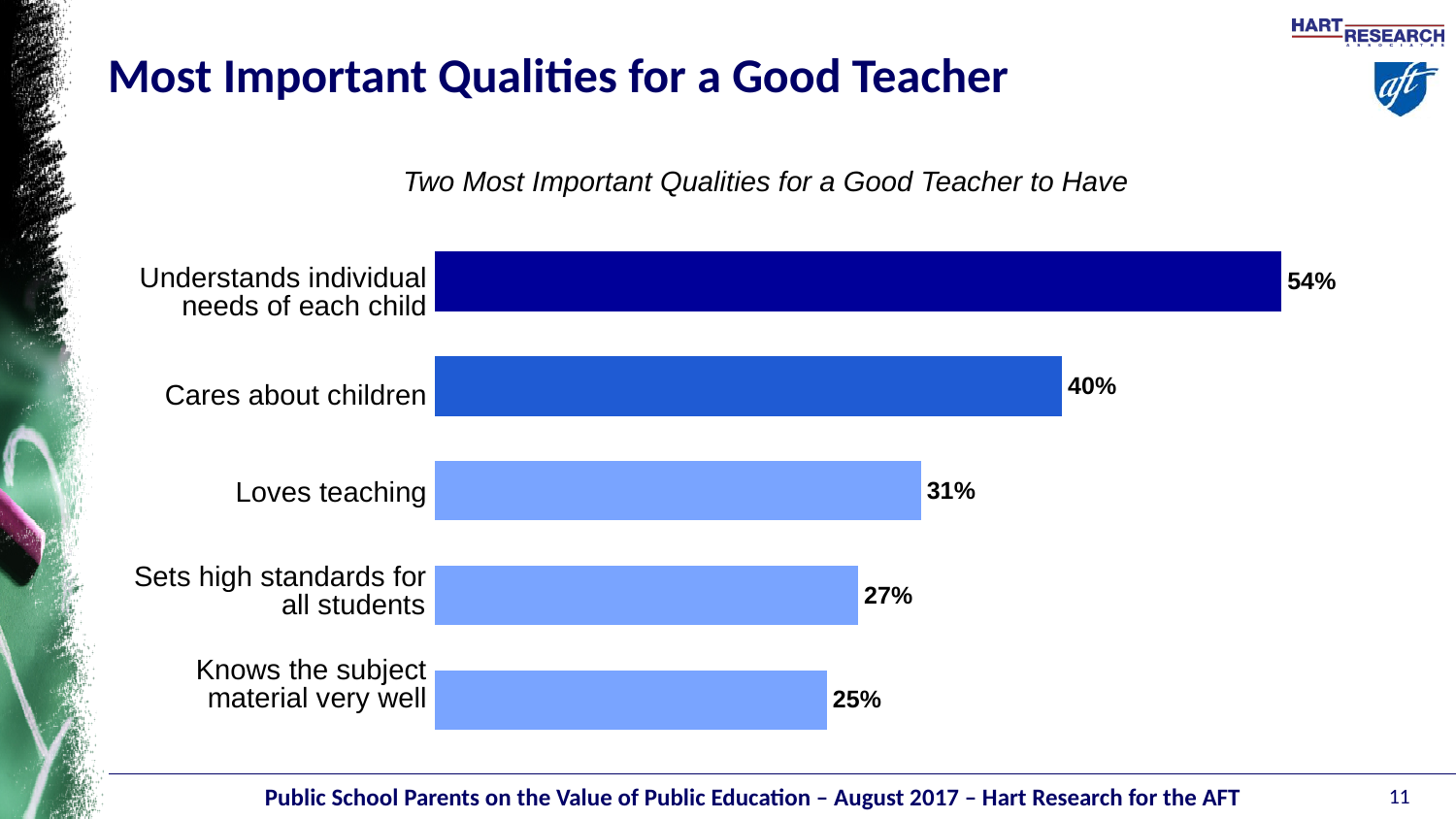
What is the subtitle shown above the chart? Two Most Important Qualities for a Good Teacher to Have What percentage is shown for "Loves teaching"? 31% What percentage of respondents chose "Understands individual needs of each child" as one of the two most important qualities? 54% How many qualities are shown in the chart? 5 What is the difference in percentage points between "Understands individual needs of each child" and "Cares about children"? 14 What value is shown for "Knows the subject material very well"? 25% What is the difference in percentage points between "Sets high standards for all students" and "Knows the subject material very well"? 2 Which quality has the lowest percentage? Knows the subject material very well What type of chart is shown on the slide? Bar chart Which has a higher value: "Loves teaching" or "Sets high standards for all students"? Loves teaching Which quality has the highest percentage? Understands individual needs of each child What value is shown for "Cares about children"? 40%